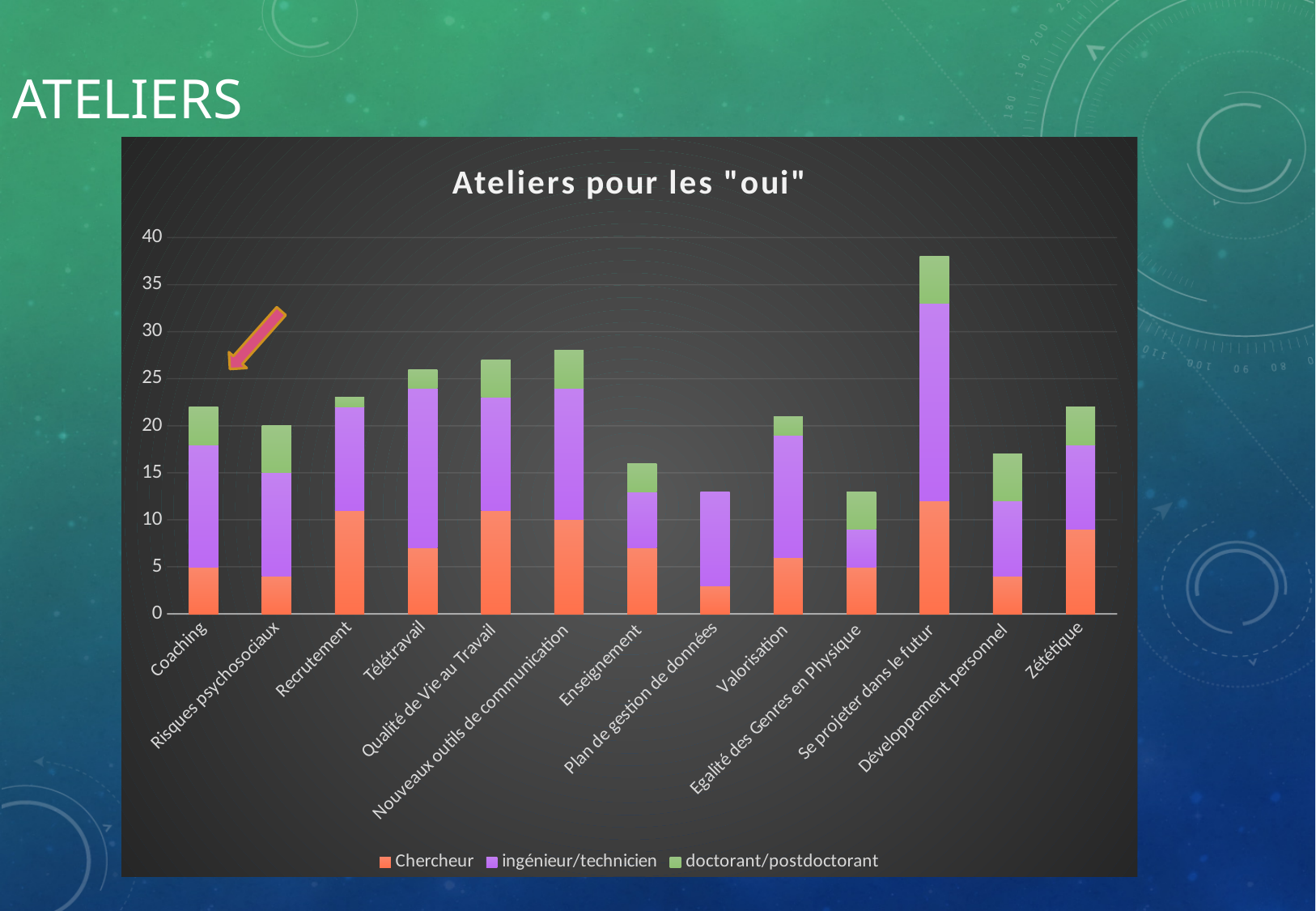
Which has the larger total bar, Se projeter dans le futur or Coaching? Se projeter dans le futur Which has the larger total bar, Nouveaux outils de communication or Enseignement? Nouveaux outils de communication What kind of chart is shown on the slide? Stacked bar chart How many series does the legend list? 3 How many workshop categories are shown on the x axis? 13 Is the total for Se projeter dans le futur greater or less than 35? greater Is the total for Enseignement greater or less than 20? less What is the title of the chart? Ateliers pour les "oui" Is the total for Nouveaux outils de communication greater or less than 25? greater Which series is shown in green in the legend? doctorant/postdoctorant Which workshop has the highest total bar? Se projeter dans le futur